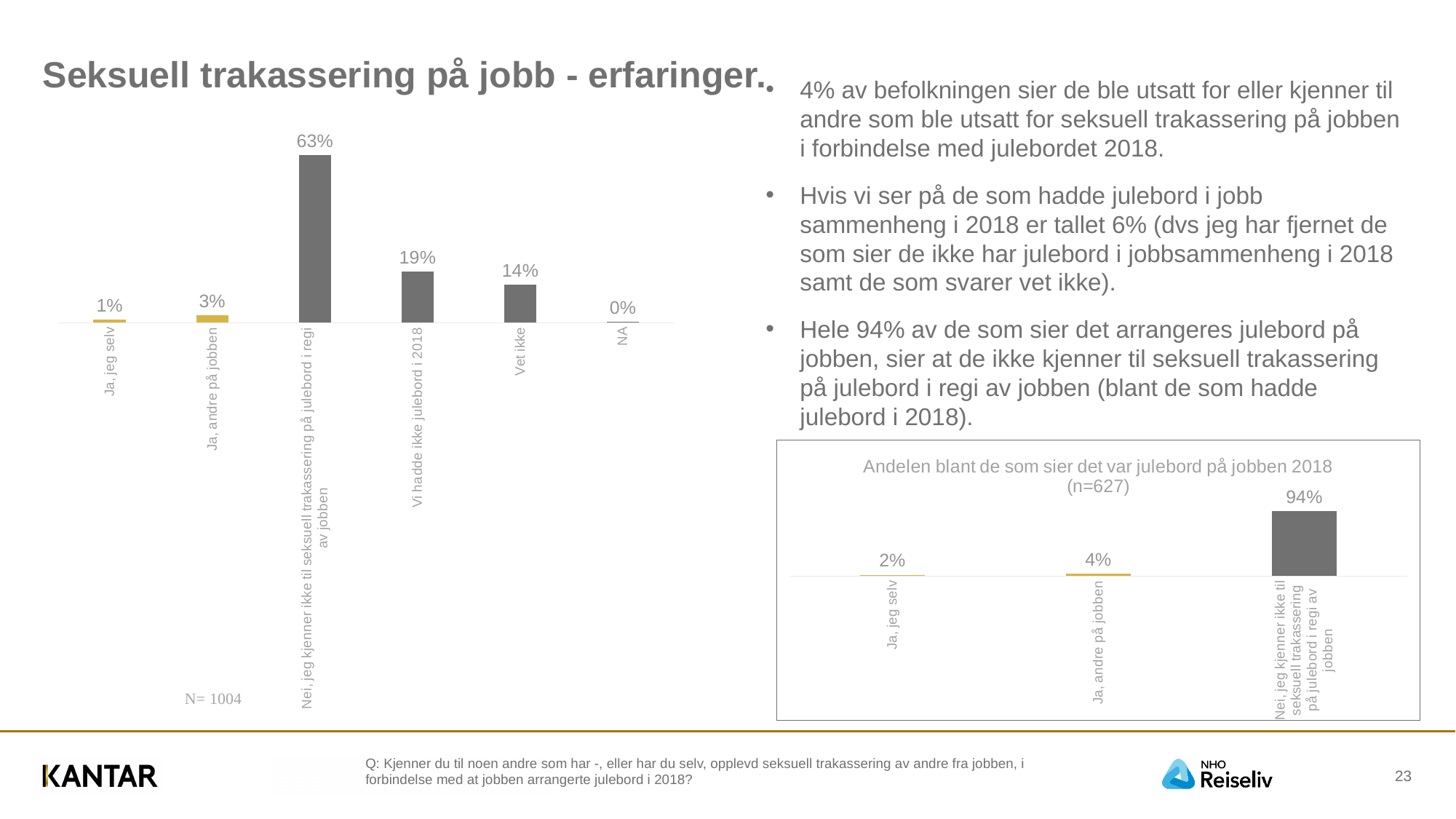
In the chart titled "Andelen blant de som sier det var julebord på jobben 2018 (n=627)", how many categories are shown? 3 In the chart titled "Andelen blant de som sier det var julebord på jobben 2018 (n=627)", which is larger: "Ja, jeg selv" or "Ja, andre på jobben"? Ja, andre på jobben In the left chart (N= 1004), how many categories are shown? 6 In the left chart (N= 1004), which category has the lowest value? NA In the left chart (N= 1004), what is the difference between "Vi hadde ikke julebord i 2018" and "Vet ikke"? 5% In the left chart (N= 1004), what is the value for "Ja, andre på jobben"? 3% In the chart titled "Andelen blant de som sier det var julebord på jobben 2018 (n=627)", what is the value for "Ja, jeg selv"? 2% In the left chart (N= 1004), which category has the highest value? Nei, jeg kjenner ikke til seksuell trakassering på julebord i regi av jobben What type of chart is the left chart (N= 1004)? Bar chart In the left chart (N= 1004), what is the value for "Vet ikke"? 14% In the chart titled "Andelen blant de som sier det var julebord på jobben 2018 (n=627)", what is the value for "Nei, jeg kjenner ikke til seksuell trakassering på julebord i regi av jobben"? 94% In the left chart (N= 1004), what is the value for "Vi hadde ikke julebord i 2018"? 19%